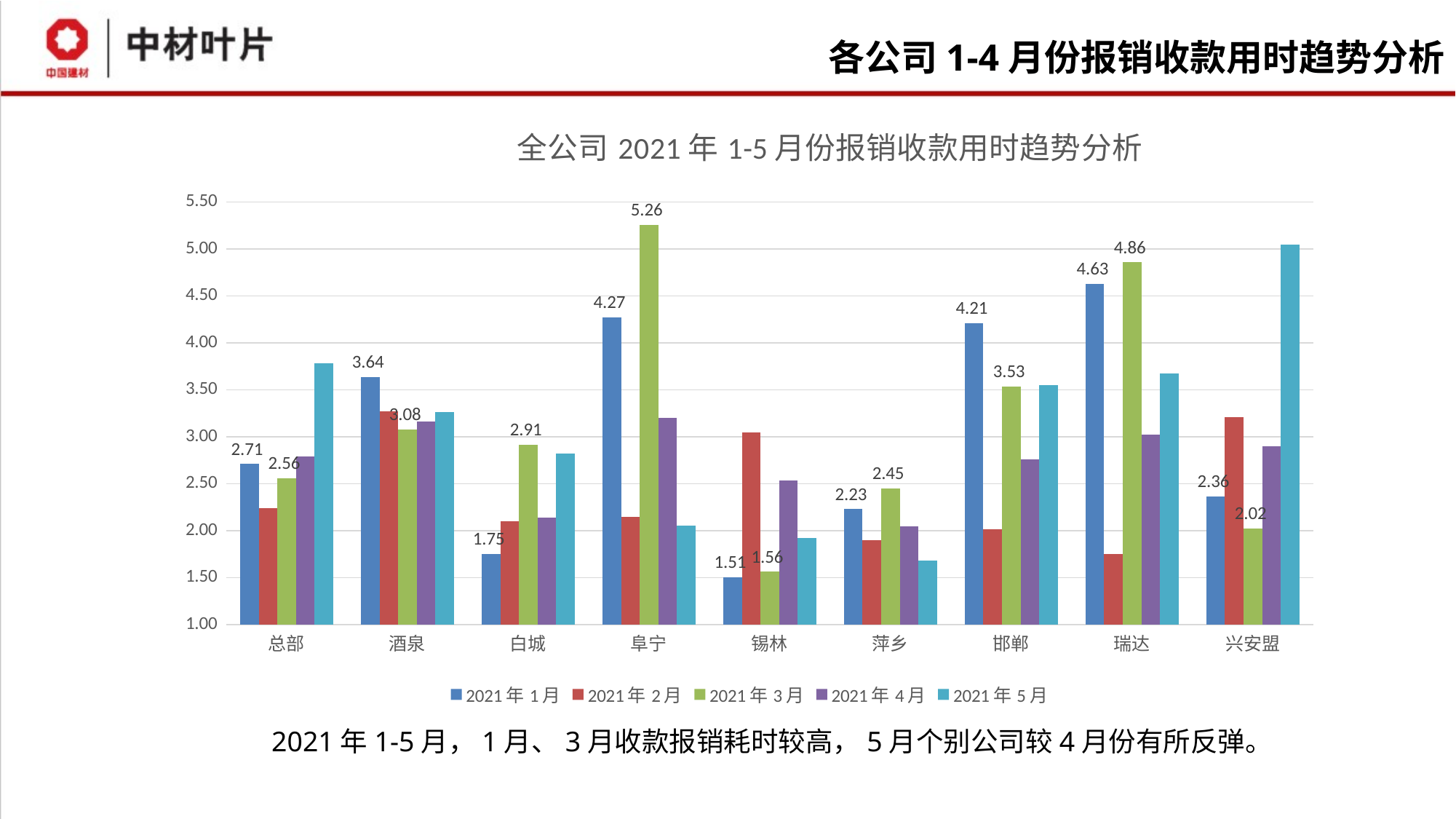
Which category has the lowest value in the 2021年1月 series? 锡林 Is the value for 兴安盟 in the 2021年5月 series greater or less than 4.50? greater Which is larger for 邯郸: the 2021年1月 value or the 2021年3月 value? 2021年1月 What is the value for 阜宁 in the 2021年3月 series? 5.26 What is the difference between the 2021年3月 and 2021年1月 values for 阜宁? 0.99 What kind of chart is shown on the slide? bar chart How many categories are shown on the x axis? 9 Is the value for 锡林 in the 2021年2月 series greater or less than 2.50? greater How many series does the legend list? 5 What is the value for 总部 in the 2021年1月 series? 2.71 What is the value for 瑞达 in the 2021年1月 series? 4.63 Which category has the highest value in the 2021年3月 series? 阜宁